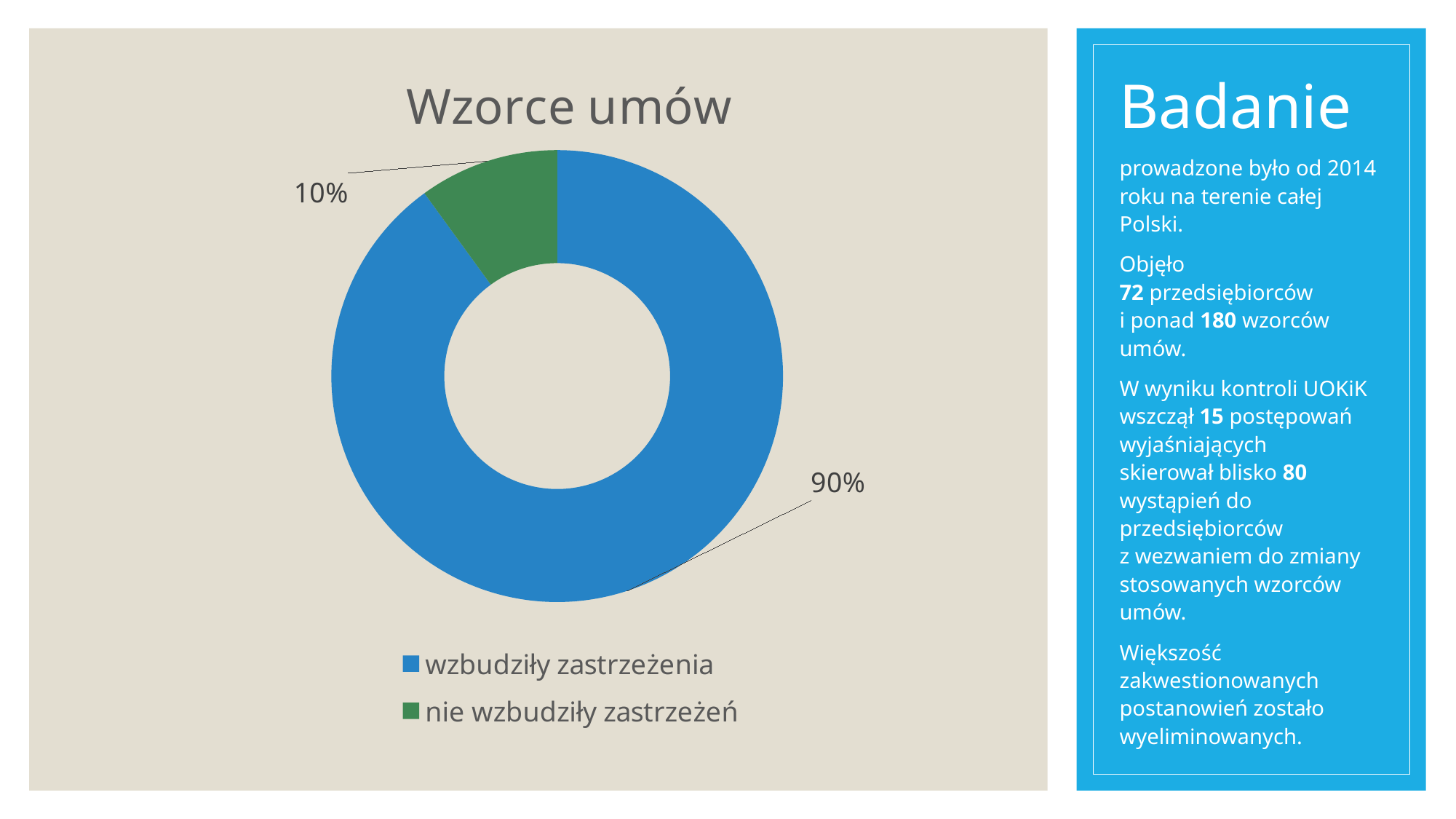
How many entries does the legend list? 2 How many categories does the chart show? 2 What is the total of the two percentages shown on the chart? 100% Which is larger: the share for "wzbudziły zastrzeżenia" or for "nie wzbudziły zastrzeżeń"? wzbudziły zastrzeżenia What is the difference in percentage points between "wzbudziły zastrzeżenia" and "nie wzbudziły zastrzeżeń"? 80 What is the title of the chart? Wzorce umów Which category has the smallest share of the chart? nie wzbudziły zastrzeżeń What percentage of the chart is labelled "nie wzbudziły zastrzeżeń"? 10% Which category has the largest share of the chart? wzbudziły zastrzeżenia What kind of chart is shown on the slide? doughnut chart What colour is the slice for "nie wzbudziły zastrzeżeń"? green What percentage of the chart is labelled "wzbudziły zastrzeżenia"? 90%